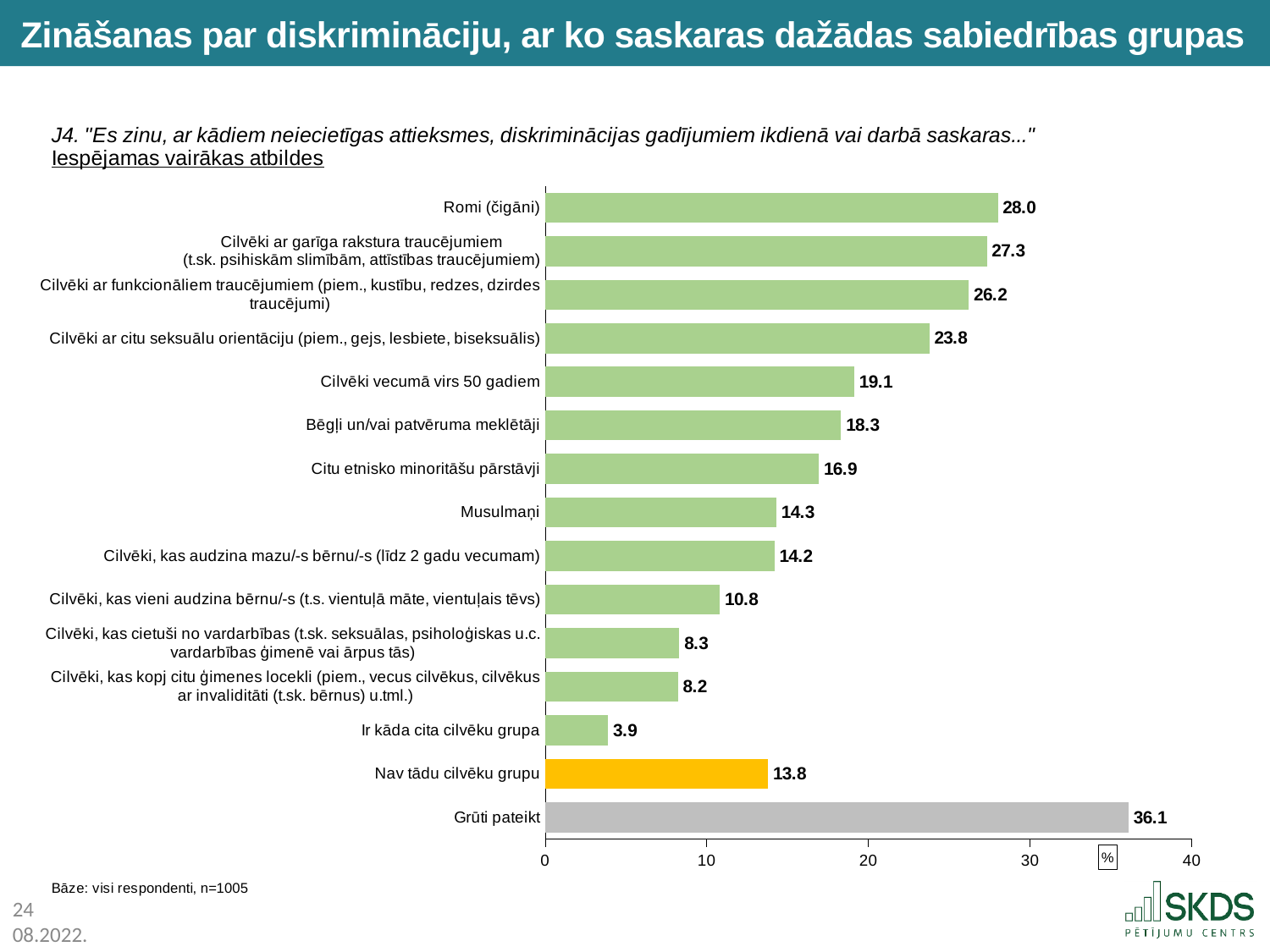
How many categories are shown in the chart? 15 Is the value for Cilvēki ar citu seksuālu orientāciju (piem., gejs, lesbiete, biseksuālis) greater or less than 20? greater What is the value for Grūti pateikt? 36.1 What is the difference between the values for Grūti pateikt and Romi (čigāni)? 8.1 What is the value for Nav tādu cilvēku grupu? 13.8 What is the value for Romi (čigāni)? 28.0 Which category has the highest value? Grūti pateikt Which category has the lowest value? Ir kāda cita cilvēku grupa What kind of chart is shown on the slide? bar chart What is the value for Bēgļi un/vai patvēruma meklētāji? 18.3 Which is larger, the value for Musulmaņi or the value for Bēgļi un/vai patvēruma meklētāji? Bēgļi un/vai patvēruma meklētāji What is the difference between the values for Cilvēki vecumā virs 50 gadiem and Bēgļi un/vai patvēruma meklētāji? 0.8